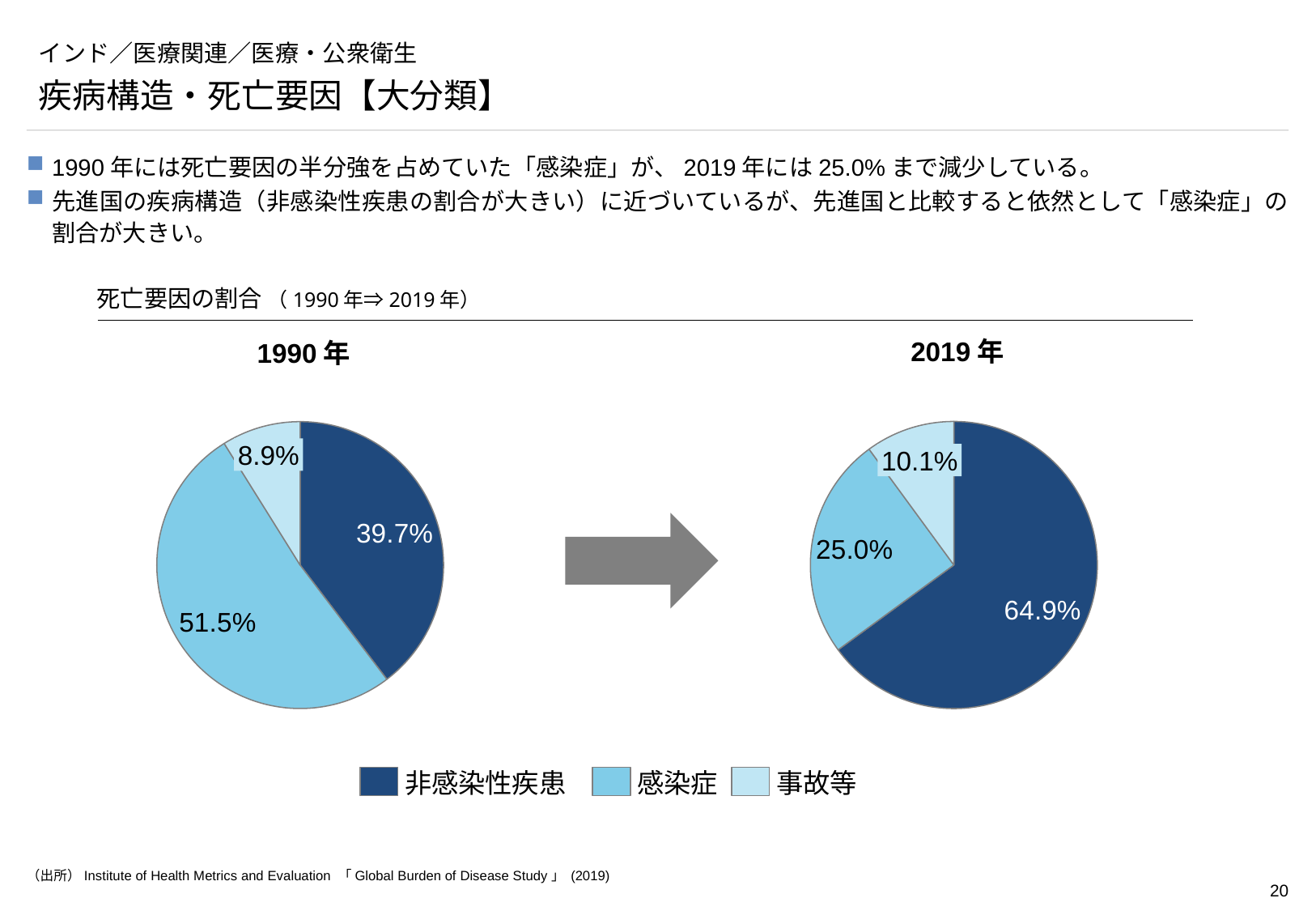
In the 1990年 pie chart, which category has the largest slice? 感染症 What is the difference between the 感染症 share in 1990年 and in 2019年? 26.5% In the 2019年 pie chart, what share is labelled for 感染症? 25.0% In the 2019年 pie chart, which category has the smallest slice? 事故等 How many slices does each pie chart have? 3 In the 1990年 pie chart, what share is labelled for 事故等? 8.9% In the 1990年 pie chart, which is larger: 非感染性疾患 or 感染症? 感染症 Which legend entry is shown in the darkest blue colour? 非感染性疾患 In the 1990年 pie chart, what share is labelled for 感染症? 51.5% How many entries does the legend list? 3 In the 2019年 pie chart, what share is labelled for 非感染性疾患? 64.9% What kind of chart is used to show 死亡要因の割合 for 1990年 and 2019年? Pie chart